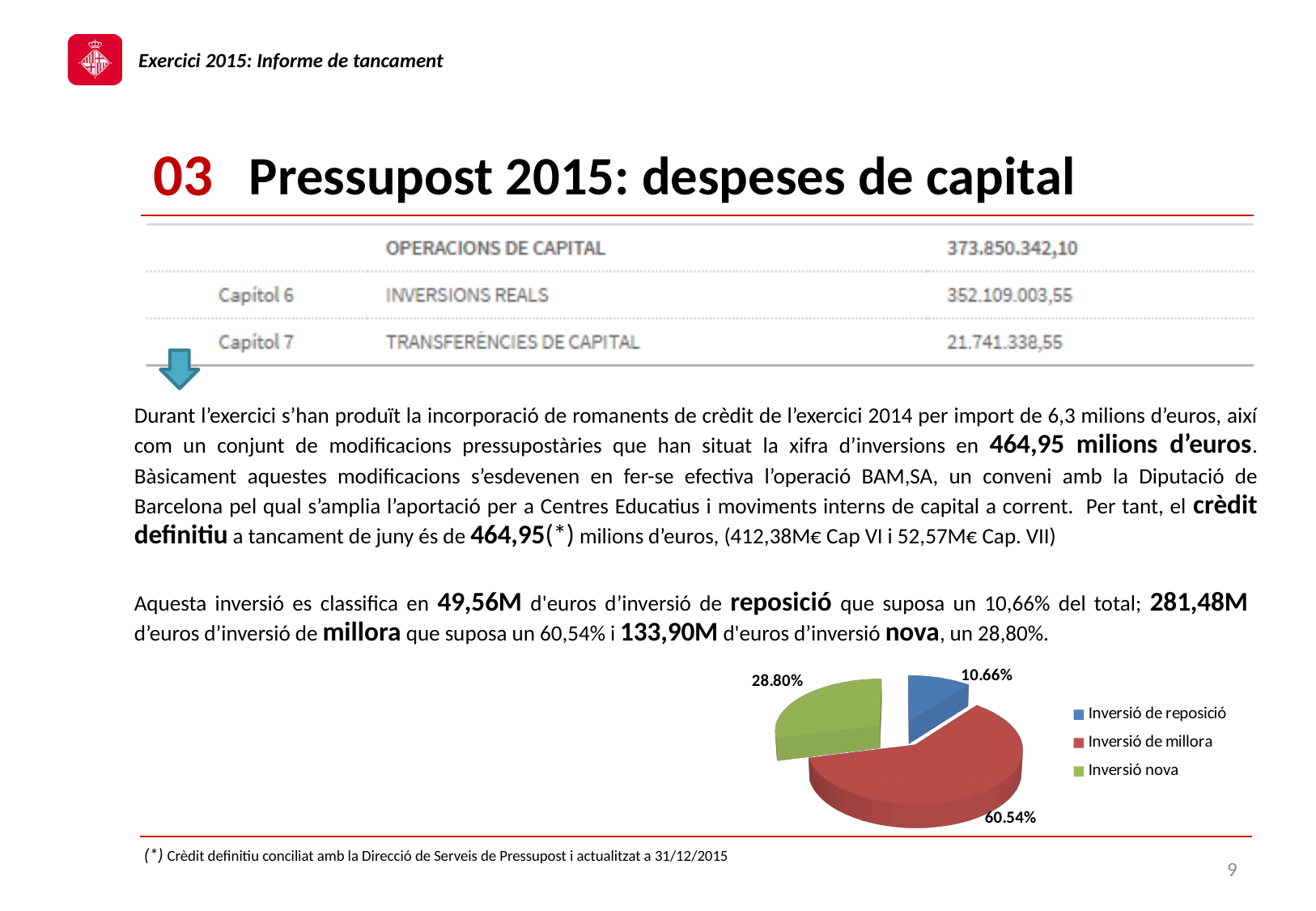
Which is larger, the slice for Inversió nova or the slice for Inversió de reposició? Inversió nova What share of the pie does Inversió nova represent? 28.80% What kind of chart is shown on the slide? pie chart What share of the pie does Inversió de millora represent? 60.54% How many slices does the pie chart have? 3 What colour is the slice for Inversió de millora? red What is the difference in percentage points between Inversió de millora and Inversió nova? 31.74 How many entries does the legend list? 3 What colour is the slice for Inversió nova? green What share of the pie does Inversió de reposició represent? 10.66% Which category has the smallest slice of the pie? Inversió de reposició Which category has the largest slice of the pie? Inversió de millora